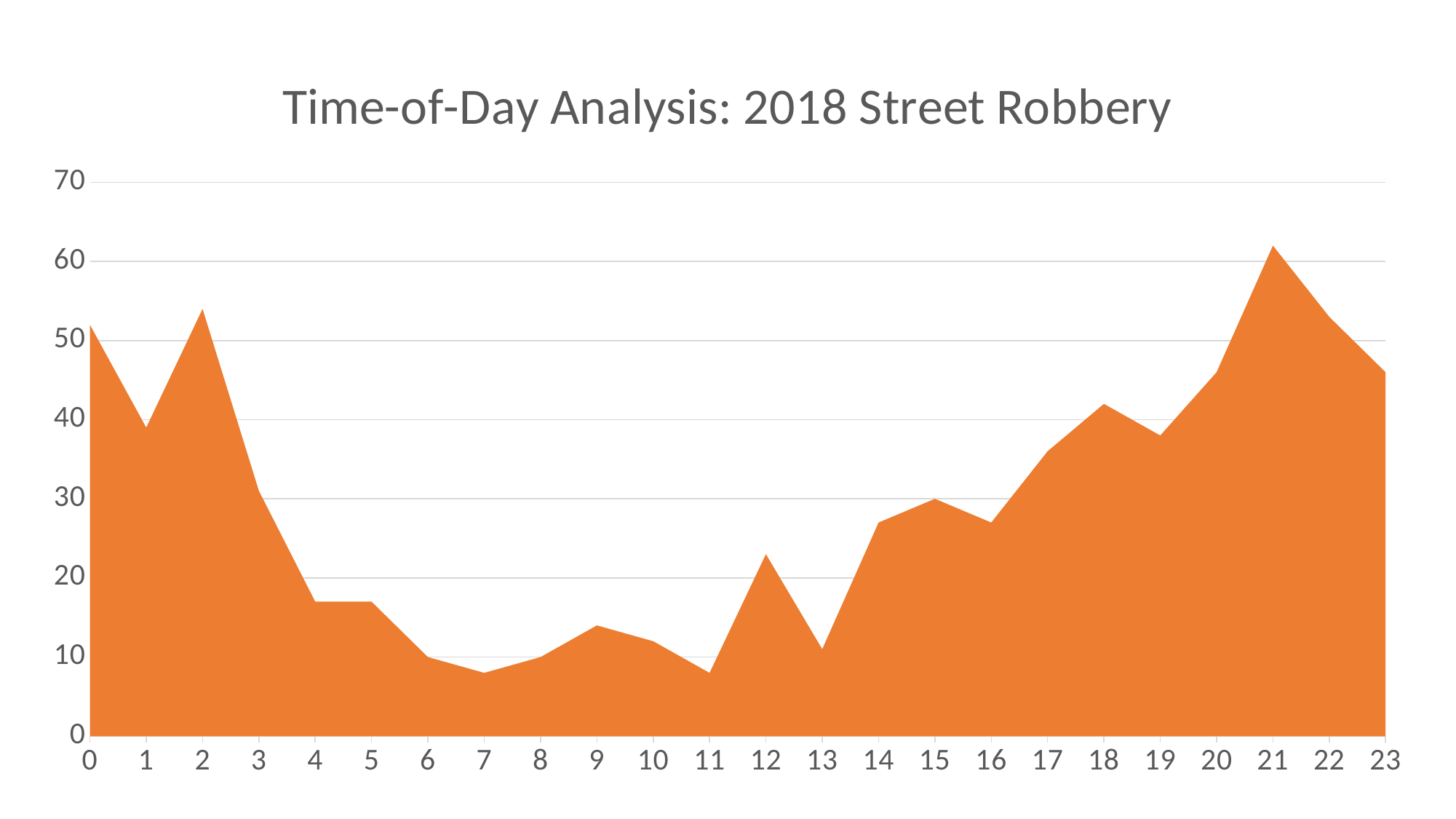
Which hour has the larger value, hour 1 or hour 2? 2 Is the value for hour 21 greater or less than 50? greater How many hours (data points) are plotted along the x axis? 24 At which hour is the value highest? 21 Is the value for hour 18 greater or less than 30? greater Do the values rise or fall from hour 3 to hour 7? fall What kind of chart is shown on the slide? area chart Is the value for hour 7 greater or less than 10? less What is the title of the chart? Time-of-Day Analysis: 2018 Street Robbery Which hour has the larger value, hour 12 or hour 13? 12